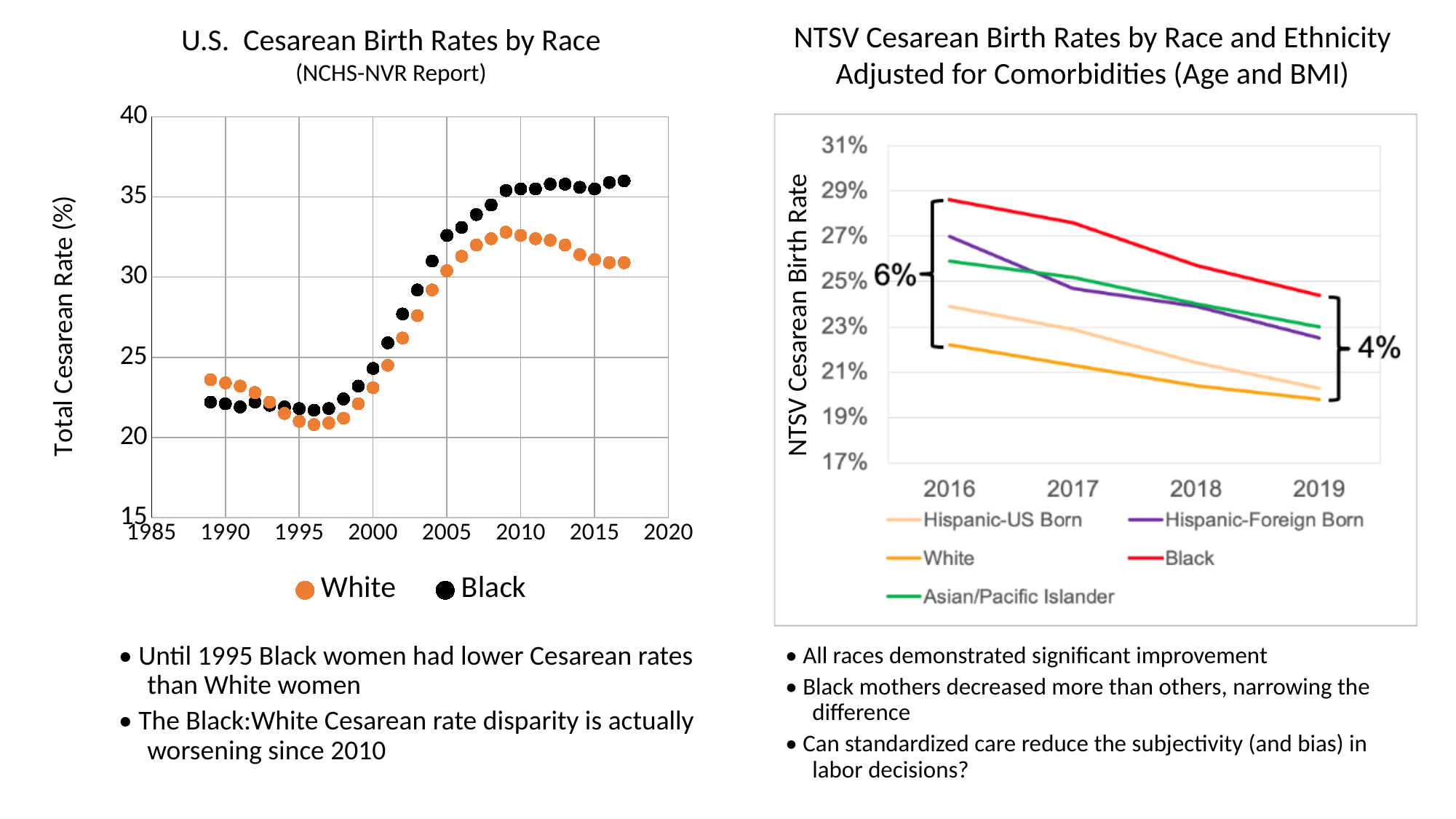
On the left chart (U.S. Cesarean Birth Rates by Race), is the value for White in 1996 greater or less than 25? less On the right chart (NTSV Cesarean Birth Rates by Race and Ethnicity), is the value for Black in 2016 greater or less than 27%? greater On the right chart (NTSV Cesarean Birth Rates by Race and Ethnicity), how many series does the legend list? 5 What kind of chart is the right chart (NTSV Cesarean Birth Rates by Race and Ethnicity)? line chart On the right chart (NTSV Cesarean Birth Rates by Race and Ethnicity), which series has the highest value in 2016? Black On the right chart (NTSV Cesarean Birth Rates by Race and Ethnicity), what gap between the highest and lowest series is annotated for 2019? 4% On the left chart (U.S. Cesarean Birth Rates by Race), how many series does the legend list? 2 On the left chart (U.S. Cesarean Birth Rates by Race), do the White values rise or fall between 2010 and 2017? fall On the right chart (NTSV Cesarean Birth Rates by Race and Ethnicity), which series has the lowest value in 2019? White On the left chart (U.S. Cesarean Birth Rates by Race), is the value for Black in 2017 greater or less than 35? greater On the left chart (U.S. Cesarean Birth Rates by Race), which series has the higher value in 2015, White or Black? Black On the left chart (U.S. Cesarean Birth Rates by Race), which series has the higher value in 1990, White or Black? White